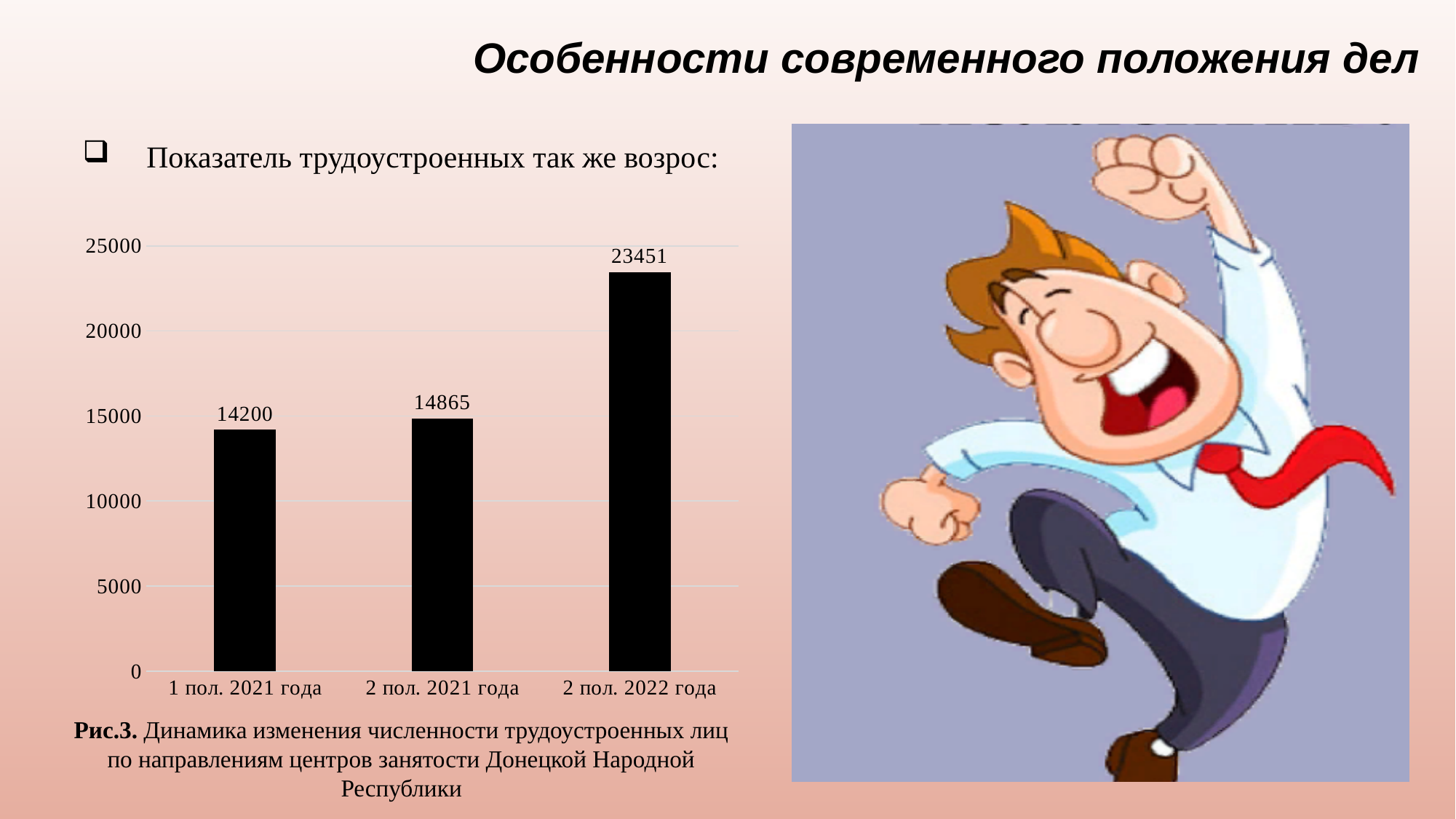
What is the difference between the values for 2 пол. 2022 года and 2 пол. 2021 года? 8586 Do the values rise or fall from left to right along the x axis? rise Which category has the highest value? 2 пол. 2022 года What kind of chart is shown on the slide? bar chart Is the value for 2 пол. 2022 года greater or less than 20000? greater Which category has the lowest value? 1 пол. 2021 года What is the value for 1 пол. 2021 года? 14200 Which is larger, the value for 2 пол. 2021 года or the value for 1 пол. 2021 года? 2 пол. 2021 года What is the difference between the values for 2 пол. 2021 года and 1 пол. 2021 года? 665 What is the value for 2 пол. 2021 года? 14865 What is the value for 2 пол. 2022 года? 23451 How many categories are shown on the x axis? 3